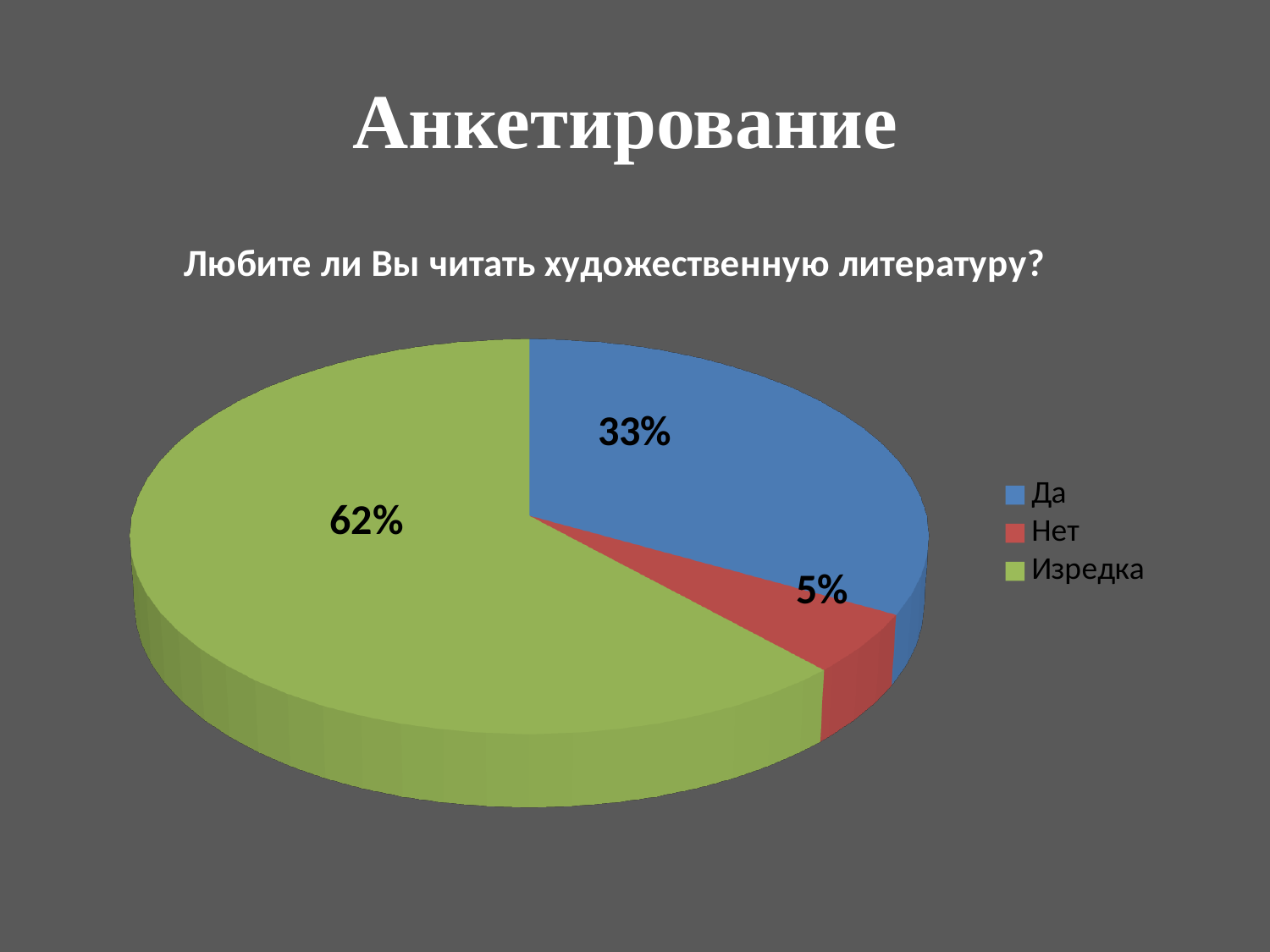
Which answer has the smallest share of the pie? Нет What percentage of respondents answered "Изредка"? 62% What is the difference in percentage points between "Изредка" and "Да"? 29 Which answer has the largest share of the pie? Изредка What kind of chart is shown on the slide? pie chart Which colour represents "Нет" in the pie chart? red Which is larger, the share for "Да" or the share for "Нет"? Да What percentage of respondents answered "Да"? 33% How many slices does the pie chart have? 3 How many entries does the legend list? 3 What is the chart's title? Любите ли Вы читать художественную литературу? What percentage of respondents answered "Нет"? 5%